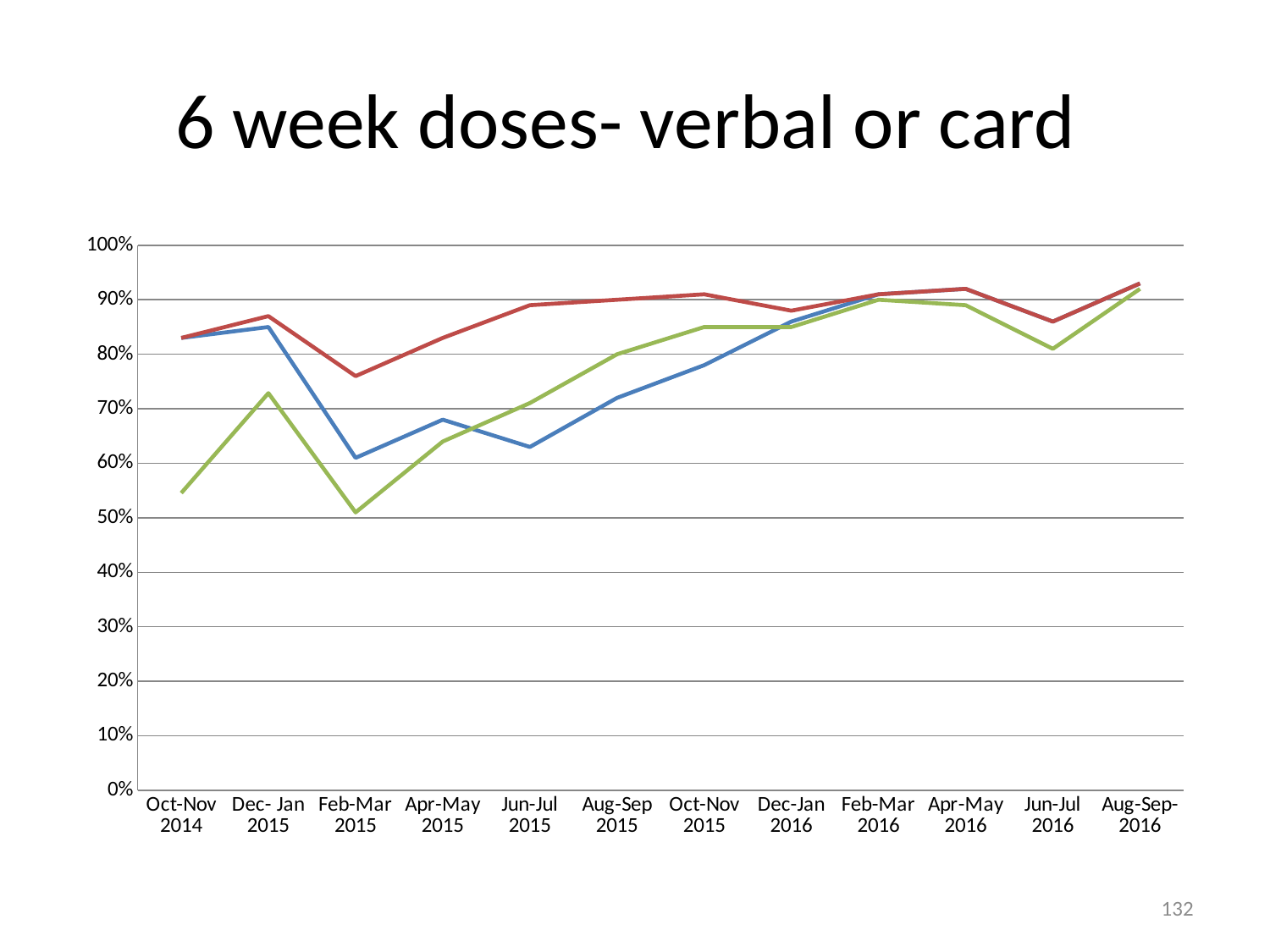
Is the value of the blue line for Jun-Jul 2015 greater or less than 70%? less Is the value of the green line for Oct-Nov 2014 greater or less than 50%? greater How many lines are plotted on the chart? 3 What is the title of the chart? 6 week doses- verbal or card Does the green line rise or fall between Feb-Mar 2015 and Feb-Mar 2016? rise What colours are the three lines on the chart? blue, red and green What kind of chart is shown on the slide? line chart At which time period does the green line reach its lowest value? Feb-Mar 2015 How many time periods are shown along the x axis? 12 Is the value of the red line for Feb-Mar 2015 greater or less than 80%? less At Feb-Mar 2015, which line is higher, the red line or the green line? the red line